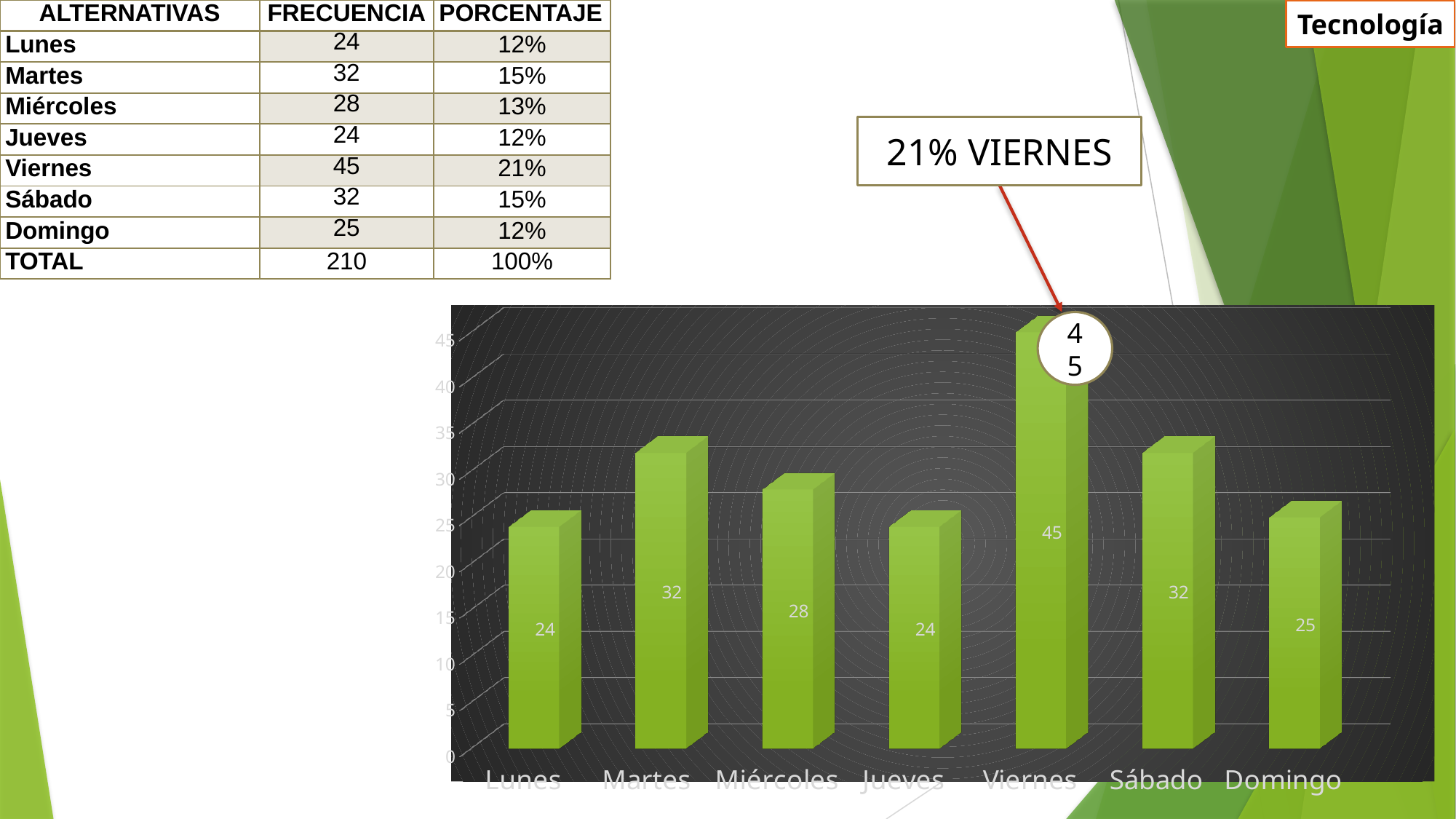
Which day has the highest value? Viernes Which is larger, the value for Sábado or the value for Domingo? Sábado Is the value for Viernes greater or less than 40? greater Which is larger, the value for Martes or the value for Miércoles? Martes What is the value for Viernes? 45 What does the callout box above the chart say? 21% VIERNES What is the difference between the values for Viernes and Martes? 13 What is the value for Domingo? 25 What is the value for Miércoles? 28 What is the difference between the values for Miércoles and Domingo? 3 How many days are shown on the x axis? 7 What kind of chart is shown? bar chart